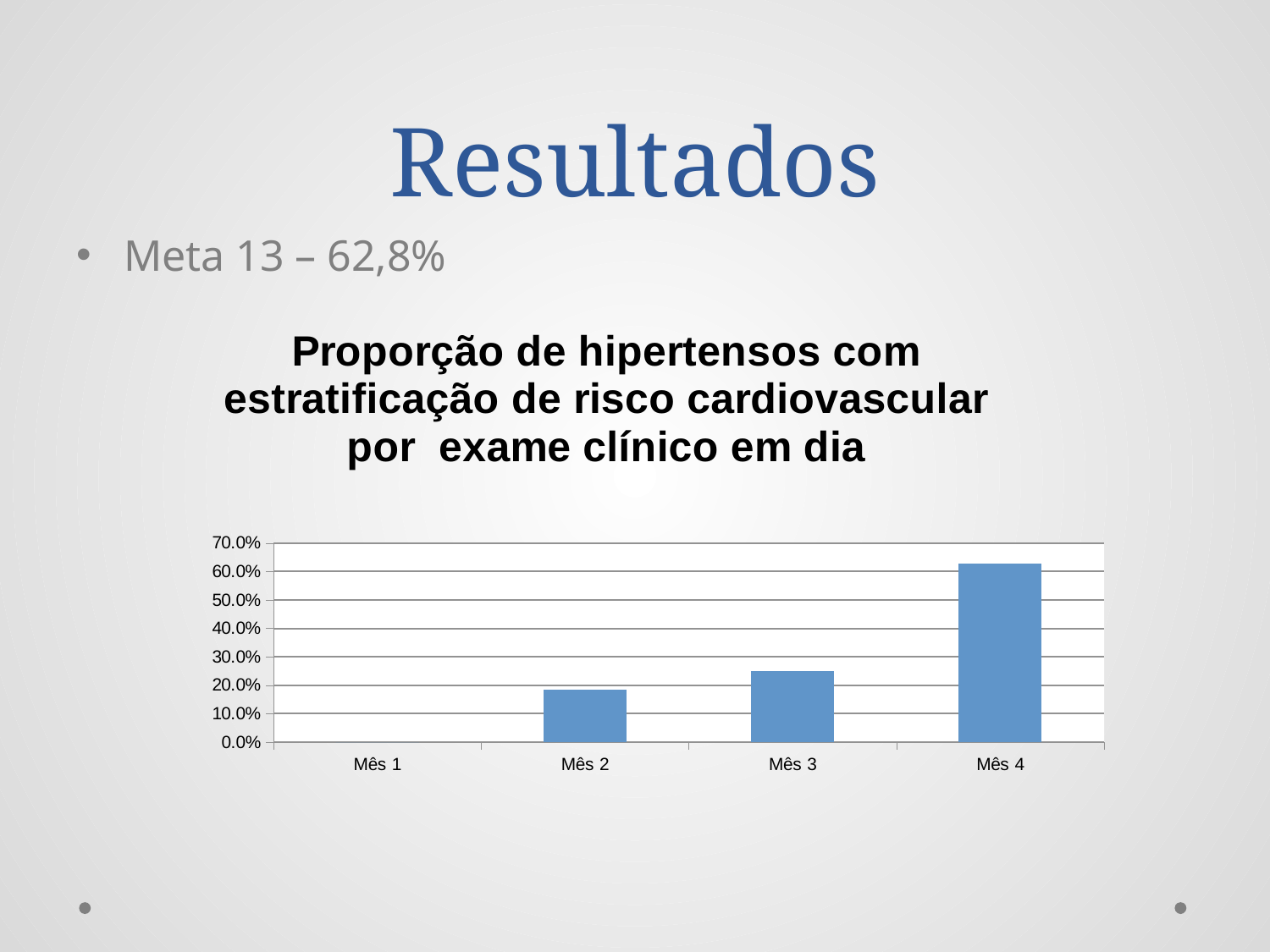
Is the value for Mês 4 greater or less than 60.0%? greater Is the value for Mês 2 greater or less than 30.0%? less Which is larger, the value for Mês 4 or the value for Mês 3? Mês 4 What is the title of the chart? Proporção de hipertensos com estratificação de risco cardiovascular por exame clínico em dia Do the values rise or fall from Mês 1 to Mês 4? rise Which month has the highest value in the chart? Mês 4 How many categories (months) are shown on the x axis of the chart? 4 Which is larger, the value for Mês 3 or the value for Mês 2? Mês 3 What kind of chart is shown on the slide? bar chart Is the value for Mês 3 greater or less than 30.0%? less Which month has the lowest value in the chart? Mês 1